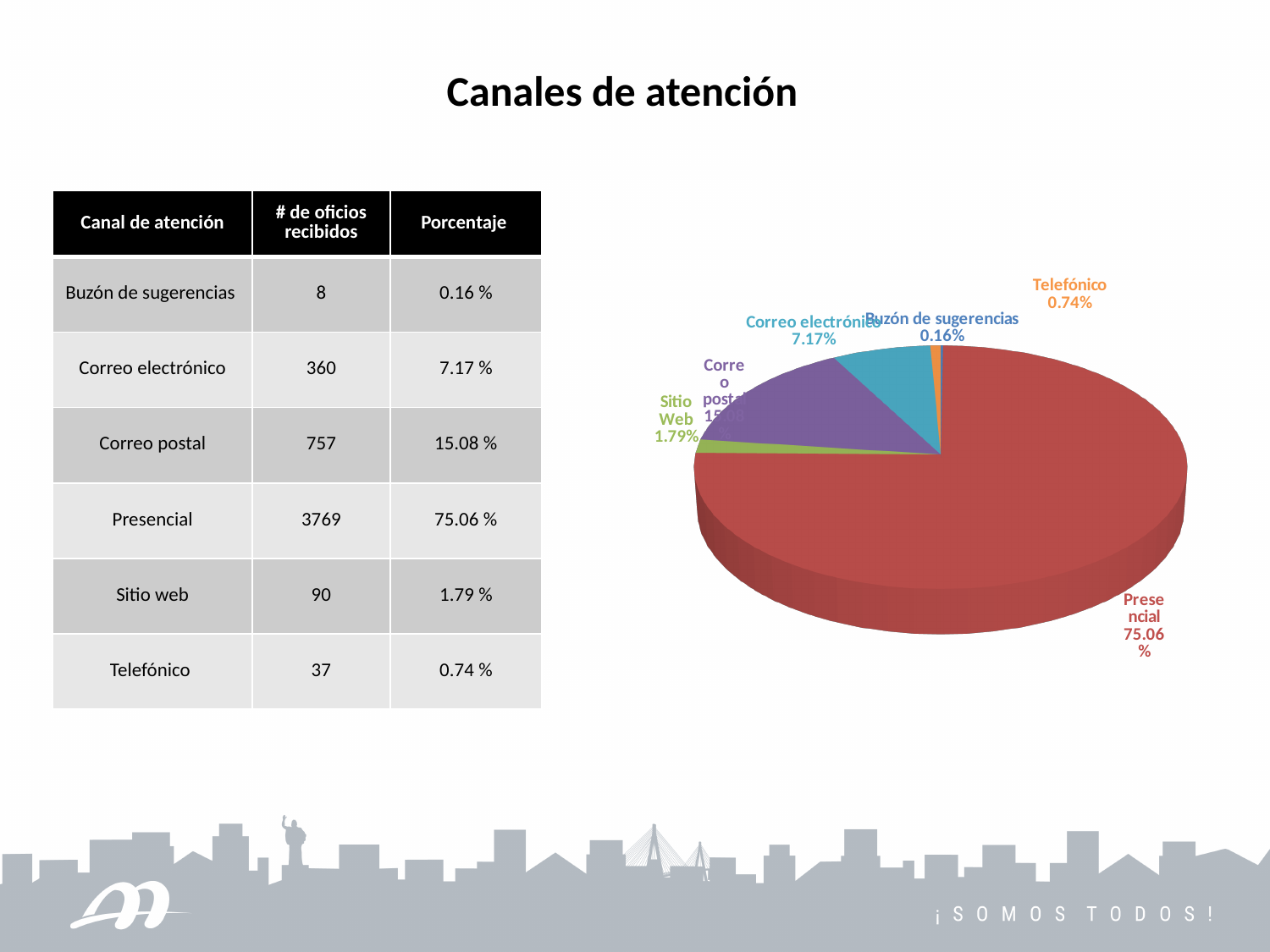
Which slice is larger in the pie chart, Telefónico or Buzón de sugerencias? Telefónico What kind of chart is shown on the slide? Pie chart What is the value shown for Buzón de sugerencias in the pie chart? 0.16% How many slices does the pie chart have? 6 What share of the pie does Presencial represent? 75.06% What is the difference between the Correo electrónico and Sitio Web values in the pie chart? 5.38% What is the value shown for Correo electrónico in the pie chart? 7.17% What is the value shown for Telefónico in the pie chart? 0.74% Which category has the smallest slice in the pie chart? Buzón de sugerencias What is the value shown for Sitio Web in the pie chart? 1.79% Which category has the largest slice in the pie chart? Presencial Which slice is larger in the pie chart, Correo postal or Correo electrónico? Correo postal